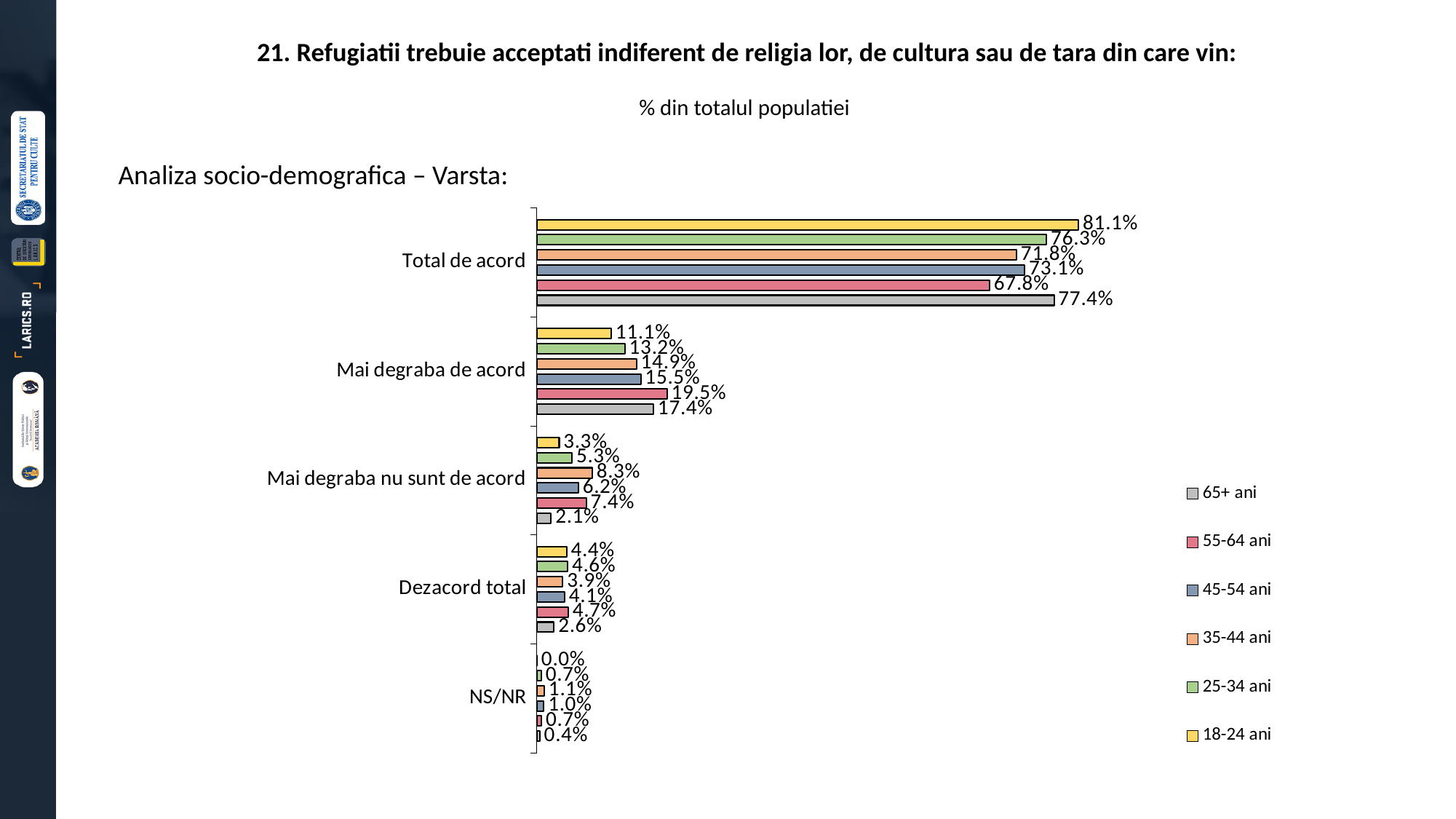
What type of chart is shown on the slide? bar chart What is the value for 18-24 ani in the Total de acord category? 81.1% Which age group has the lowest value in the Total de acord category? 55-64 ani What is the value for 65+ ani in the Mai degraba nu sunt de acord category? 2.1% Which age group has the lowest value in the NS/NR category? 18-24 ani What is the subtitle shown above the chart? % din totalul populatiei In the Dezacord total category, which is larger: the value for 55-64 ani or the value for 65+ ani? 55-64 ani How many series does the legend list? 6 Which age group has the highest value in the Total de acord category? 18-24 ani What is the value for 55-64 ani in the Mai degraba de acord category? 19.5% What is the difference between the 18-24 ani and 55-64 ani values in the Total de acord category? 13.3% How many response categories are shown on the chart? 5